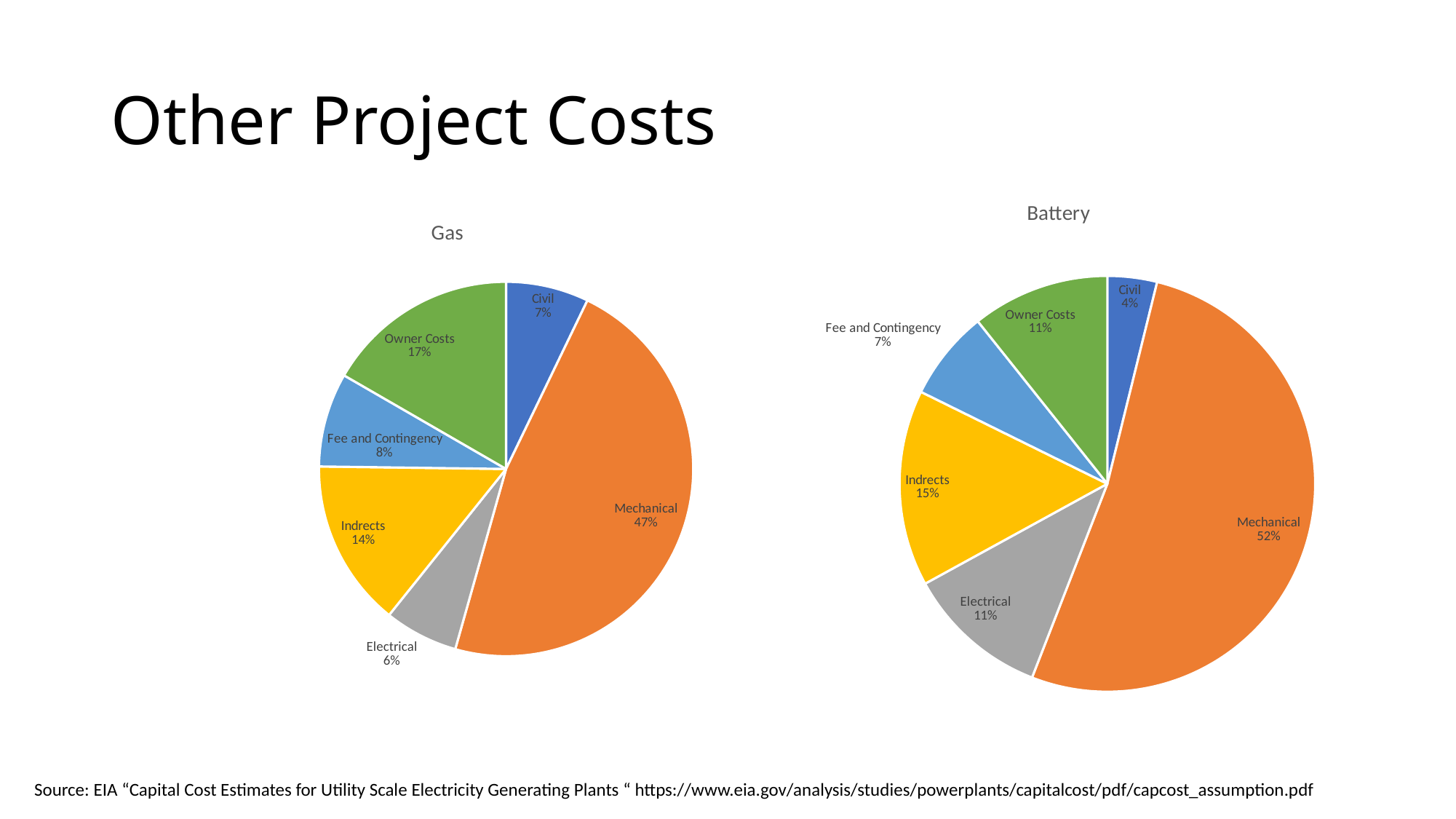
In the Gas chart, what is the value for Owner Costs? 17% How many categories are shown in the Gas chart? 6 In the Gas chart, what share does Mechanical have? 47% In the Gas chart, which is larger: Indrects or Fee and Contingency? Indrects What is the title of the chart on the left? Gas In the Battery chart, which category has the largest slice? Mechanical In the Gas chart, which category has the smallest slice? Electrical In the Battery chart, what share does Mechanical have? 52% In the Battery chart, which category has the smallest slice? Civil What type of chart is the Battery chart? Pie chart What is the difference between the Mechanical share in the Battery chart and the Mechanical share in the Gas chart? 5% In the Battery chart, what is the value for Indrects? 15%